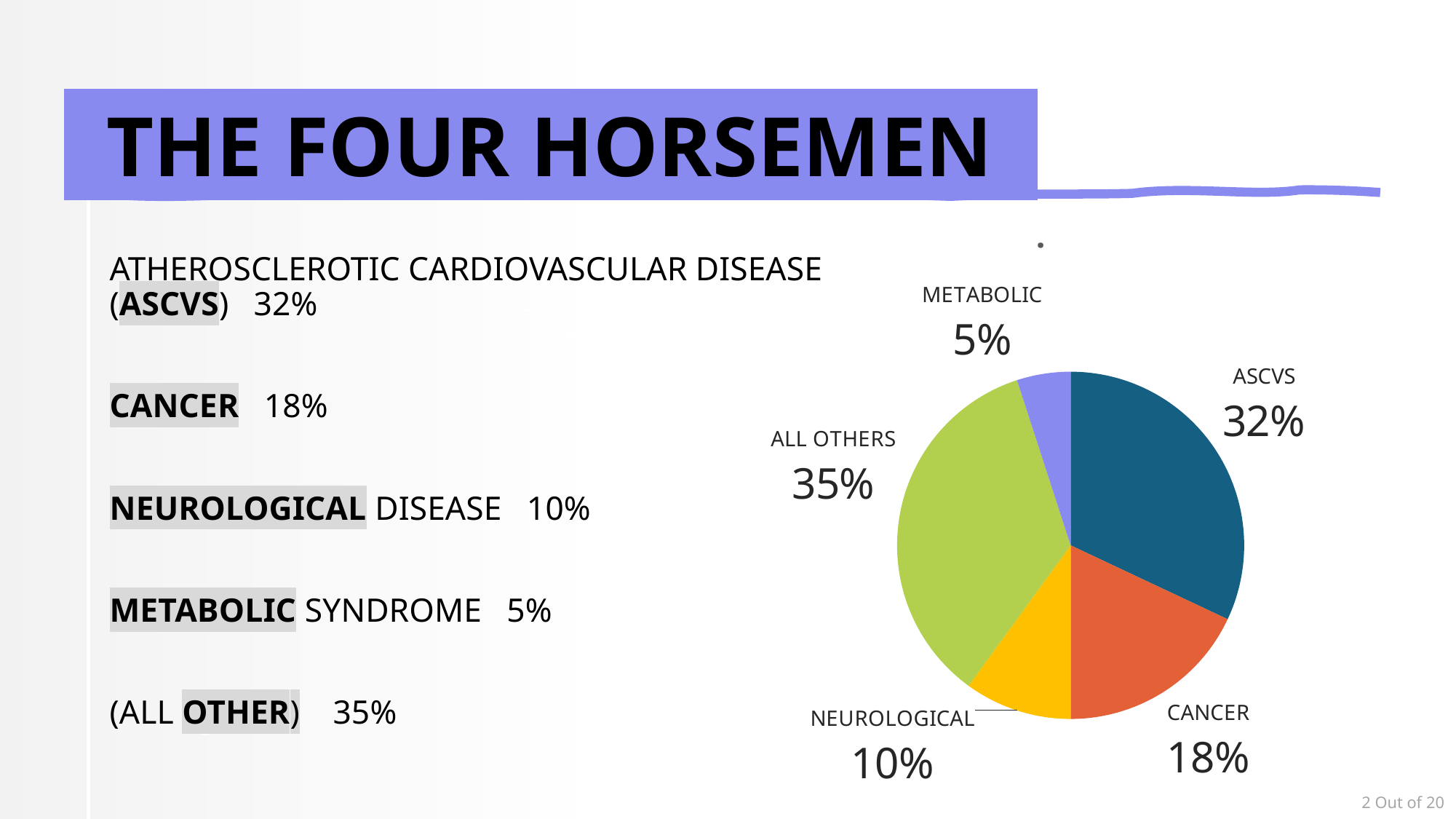
What percentage does the ASCVS slice represent? 32% What is the combined share of the ASCVS and ALL OTHERS slices? 67% Which slice of the pie chart is the smallest? METABOLIC What percentage does the METABOLIC slice represent? 5% What is the difference between the ASCVS and CANCER percentages? 14% What percentage does the CANCER slice represent? 18% What type of chart is shown on the slide? pie chart Which is larger, the CANCER slice or the NEUROLOGICAL slice? CANCER How many slices does the pie chart have? 5 Which slice of the pie chart is the largest? ALL OTHERS What colour is the ALL OTHERS slice? green What percentage does the NEUROLOGICAL slice represent? 10%